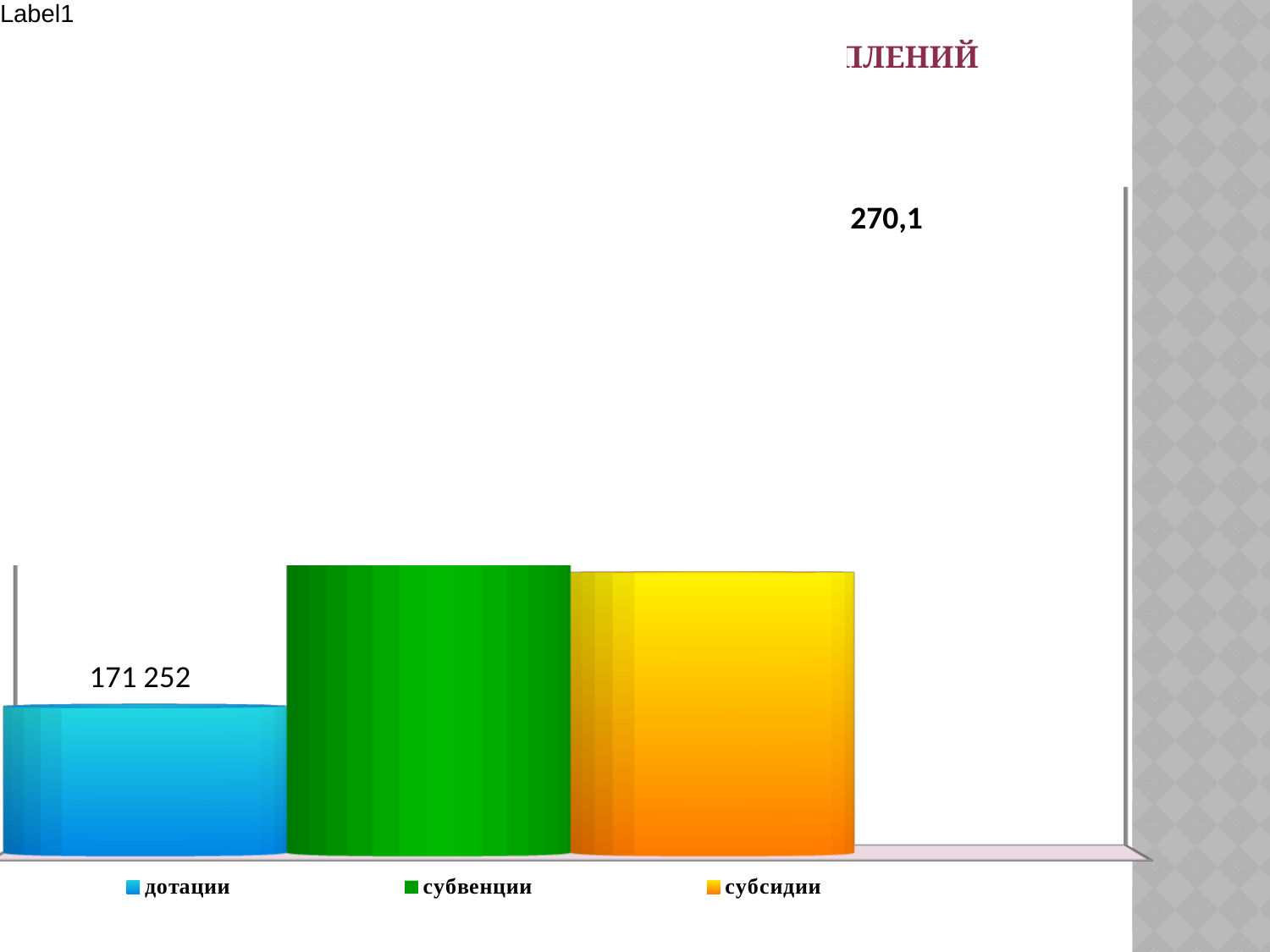
Which category has the lowest bar? дотации How many entries does the legend list? 3 How many bars are plotted on the chart? 3 What kind of chart is shown on the slide? bar chart Which is larger, the bar for дотации or the bar for субвенции? субвенции What are the three legend entries on the chart? дотации, субвенции, субсидии Which is larger, the bar for дотации or the bar for субсидии? субсидии What colour is the bar for субвенции? green